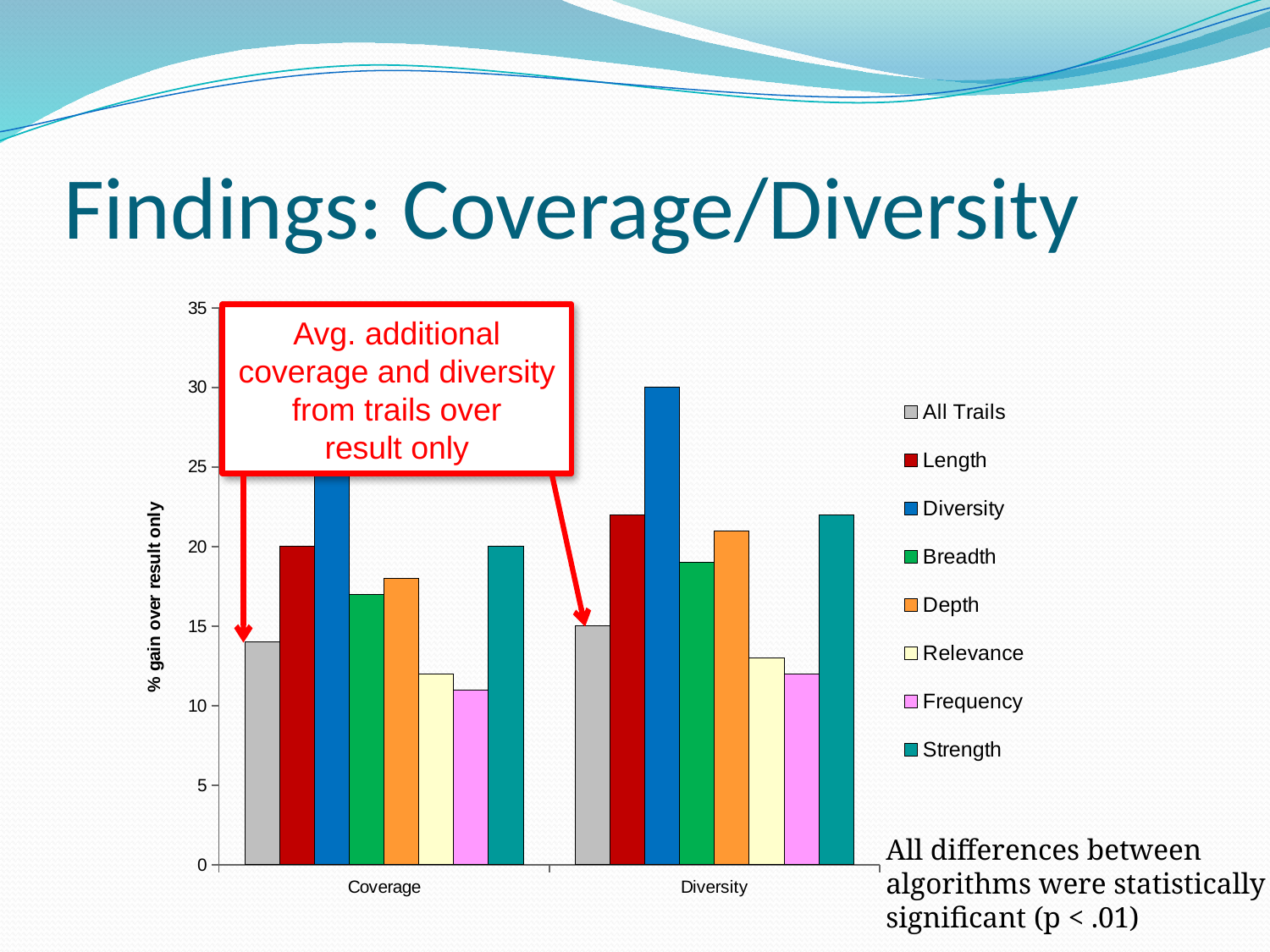
How many categories are shown on the x axis? 2 What kind of chart is shown on the slide? bar chart How many series does the legend list? 8 What is the label of the y axis? % gain over result only What is the value of the Diversity series in the Diversity category? 30 Is the Diversity series larger in the Coverage category or in the Diversity category? Diversity Which series has the highest value in the Diversity category? Diversity Is the value for Depth in the Diversity category greater or less than 20? greater Is the value for All Trails in the Coverage category greater or less than 15? less Which series has the lowest value in the Coverage category? Frequency Is the value for Breadth in the Coverage category greater or less than 20? less What is the value of the Length series in the Coverage category? 20